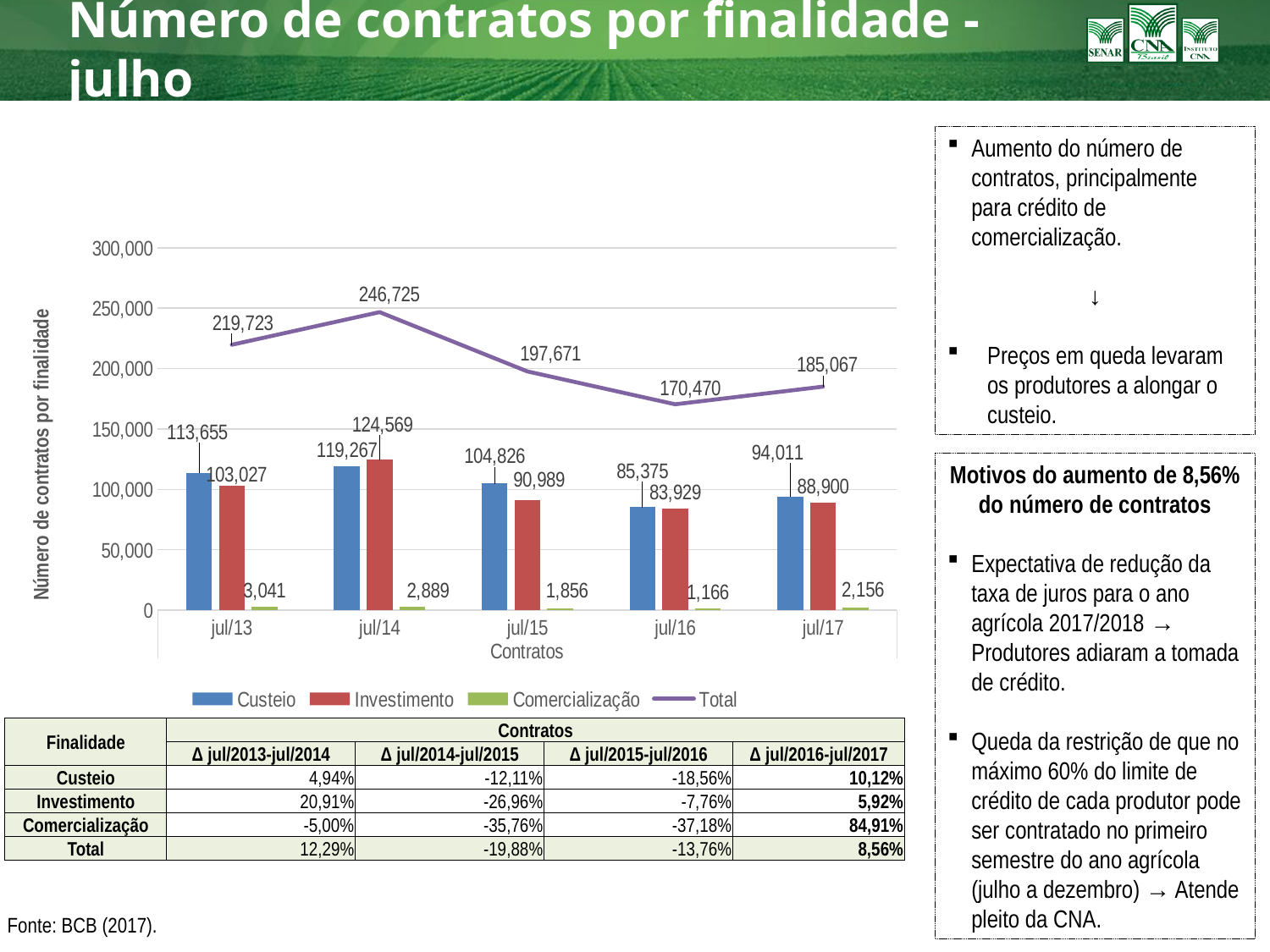
What is the Total value in jul/14? 246,725 How many periods are shown on the x axis of the chart? 5 In which period is the Total line at its highest? jul/14 What is the value for Custeio in jul/15? 104,826 In jul/14, which is larger: Custeio or Investimento? Investimento Is the value for Custeio in jul/16 greater or less than 100,000? less What is the value for Investimento in jul/17? 88,900 How many series does the chart legend list? 4 Does the Total line rise or fall from jul/14 to jul/16? fall What is the difference between the Total in jul/17 and the Total in jul/16? 14,597 By how much did the Custeio value increase from jul/13 to jul/14? 5,612 In which period is the Comercialização value lowest? jul/16